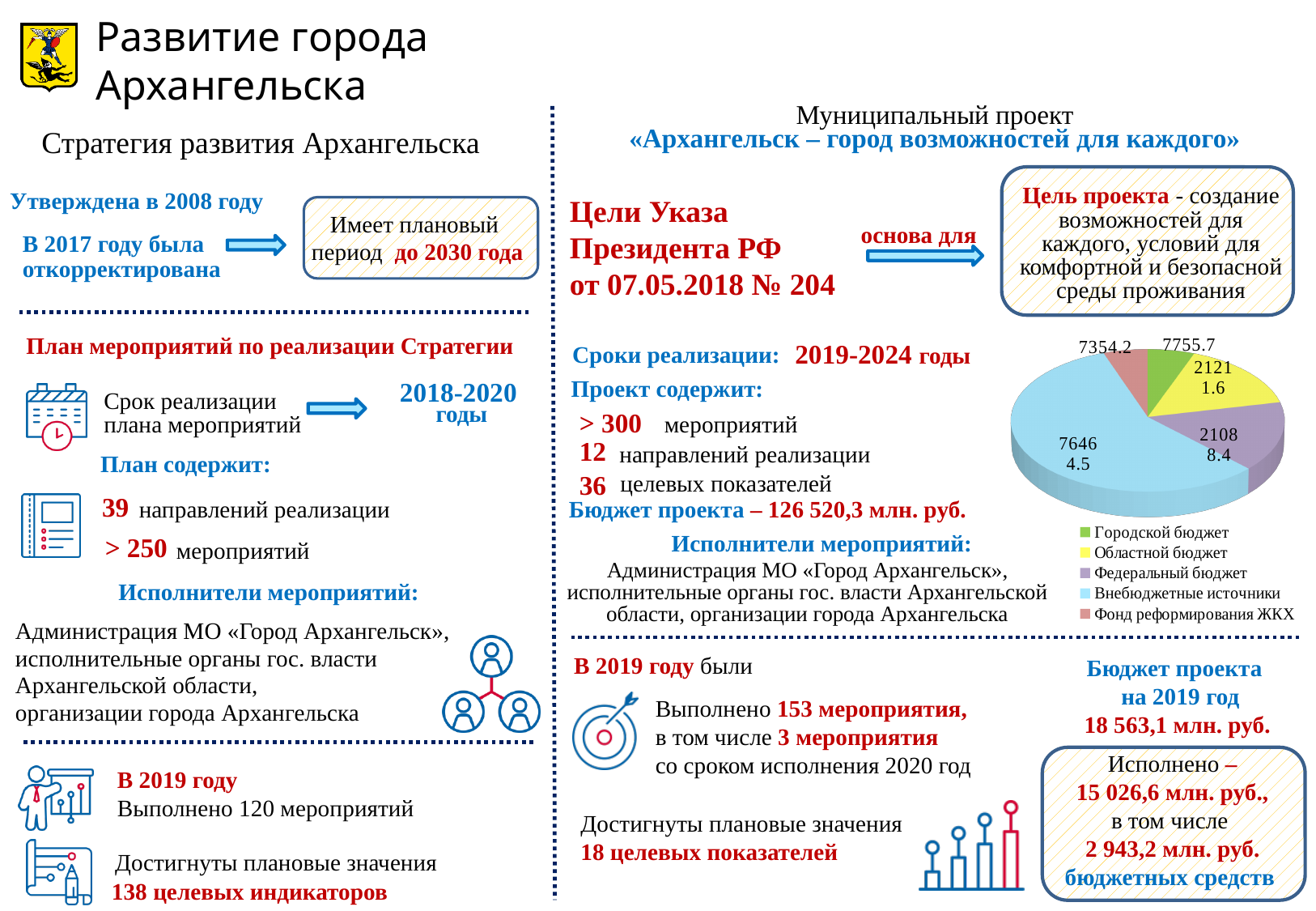
What is the value for Областной бюджет in the pie chart? 21211.6 Which category has the smallest slice in the pie chart? Фонд реформирования ЖКХ Which is larger in the pie chart: Областной бюджет or Федеральный бюджет? Областной бюджет How many slices does the pie chart have? 5 What is the value for Фонд реформирования ЖКХ in the pie chart? 7354.2 What is the difference between the values for Городской бюджет and Фонд реформирования ЖКХ in the pie chart? 401.5 What kind of chart is shown on the slide? pie chart Which is larger in the pie chart: Городской бюджет or Фонд реформирования ЖКХ? Городской бюджет What is the value for Городской бюджет in the pie chart? 7755.7 What is the value for Внебюджетные источники in the pie chart? 76464.5 What colour represents Внебюджетные источники in the pie chart? light blue Which category has the largest slice in the pie chart? Внебюджетные источники